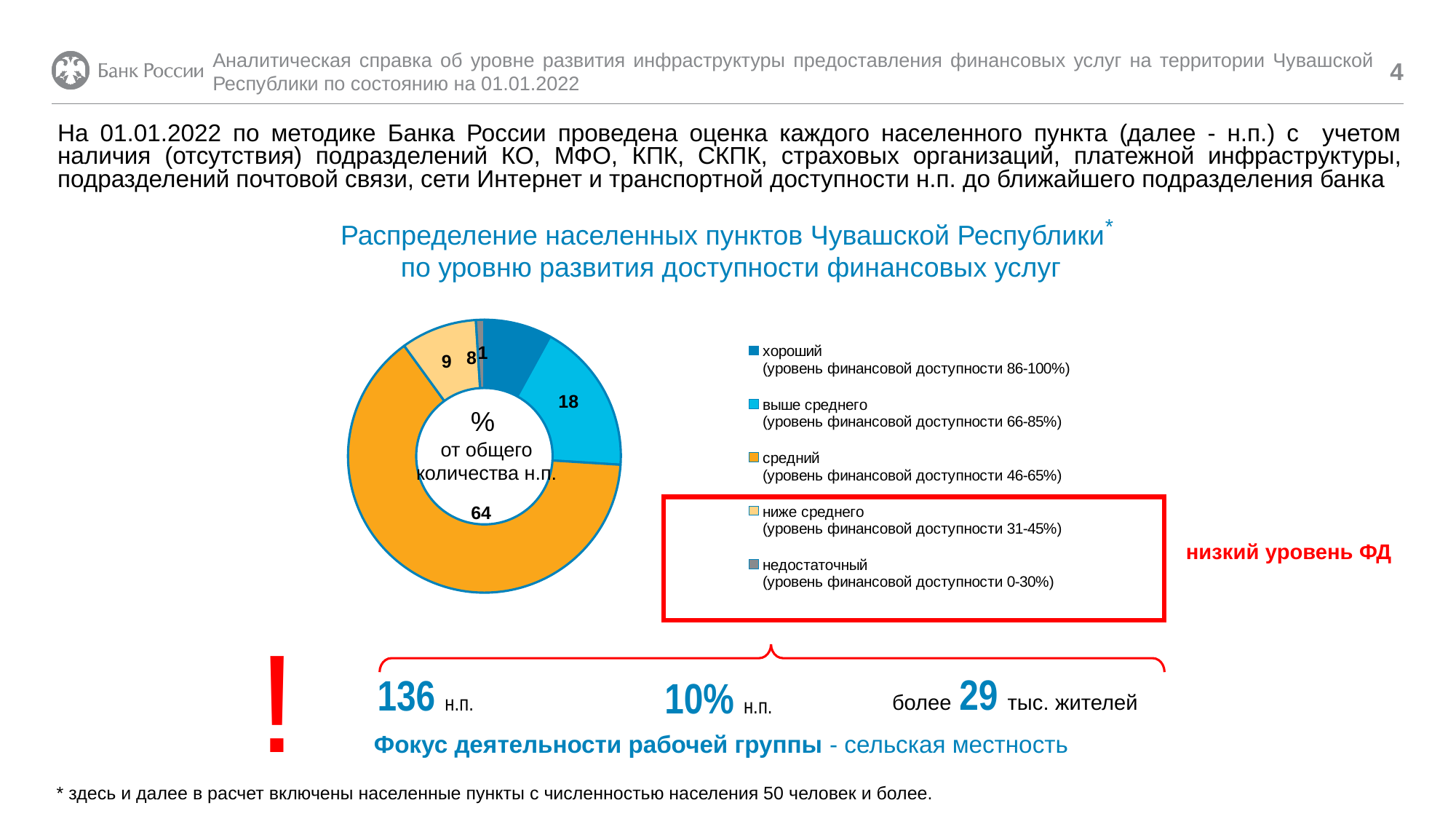
What share of settlements falls into the "средний" category in the doughnut chart? 64 What type of chart is shown on the slide? doughnut chart What value is shown for the "недостаточный" category? 1 Which category has the smallest share in the doughnut chart? недостаточный Which category has the largest share in the doughnut chart? средний What is the difference between the "средний" and "выше среднего" values? 46 What value is shown for the "выше среднего" category? 18 What is the combined value of the "ниже среднего" and "недостаточный" categories? 10 How many categories does the doughnut chart show? 5 What value is shown for the "хороший" category? 8 What value is shown for the "ниже среднего" category? 9 Which is larger: the value for "ниже среднего" or for "хороший"? ниже среднего